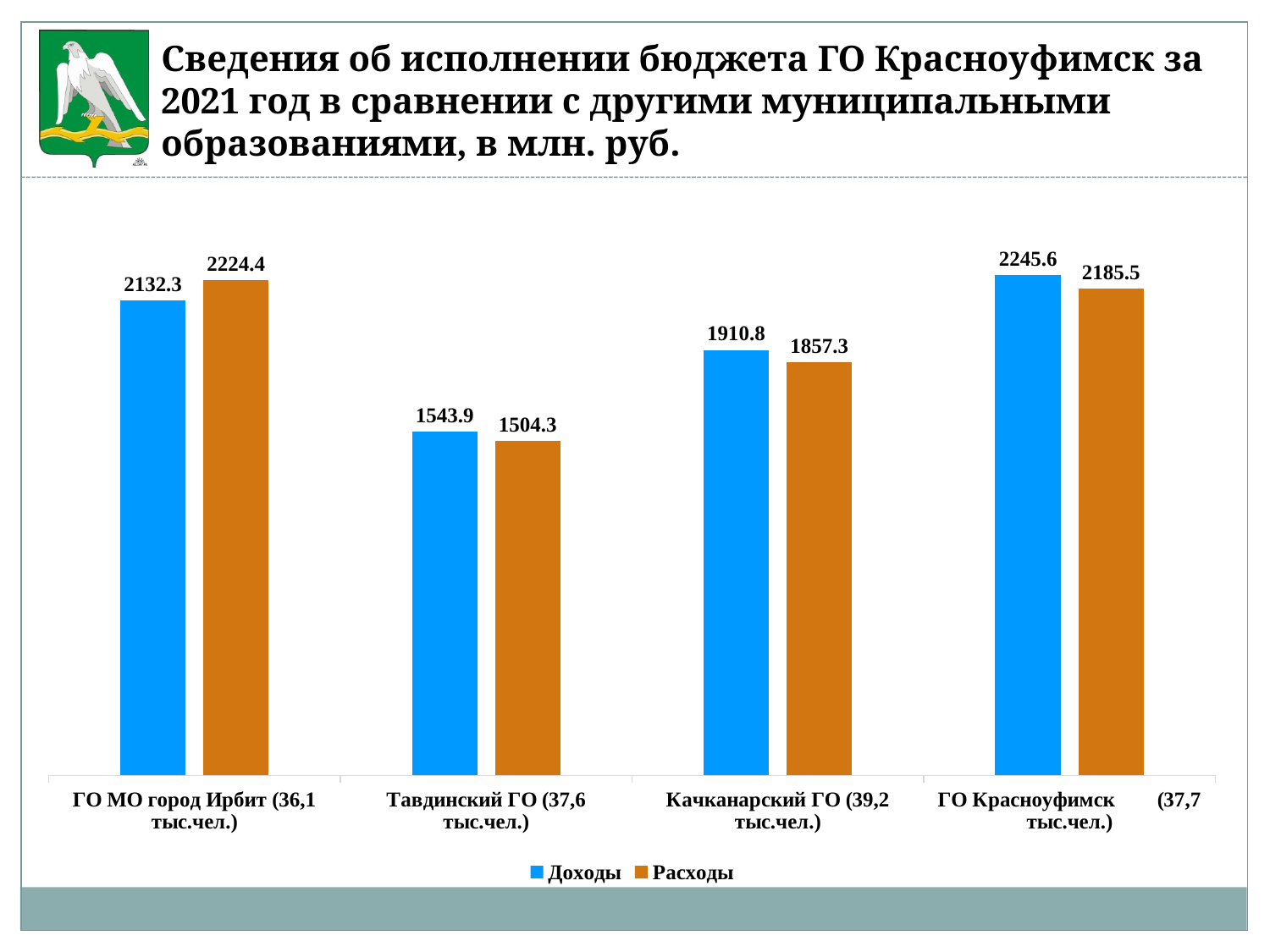
What is the value of Доходы for Качканарский ГО? 1910.8 What is the difference between Доходы and Расходы for ГО Красноуфимск? 60.1 What is the value of Расходы for Тавдинский ГО? 1504.3 How many series does the legend list? 2 Which municipality has the highest Доходы? ГО Красноуфимск What is the difference between Расходы and Доходы for ГО МО город Ирбит? 92.1 What is the value of Доходы for ГО МО город Ирбит? 2132.3 How many municipalities are shown on the chart? 4 Which municipality has the lowest Расходы? Тавдинский ГО What is the value of Расходы for ГО Красноуфимск? 2185.5 For Качканарский ГО, which is larger: Доходы or Расходы? Доходы Which municipality has the highest Расходы? ГО МО город Ирбит